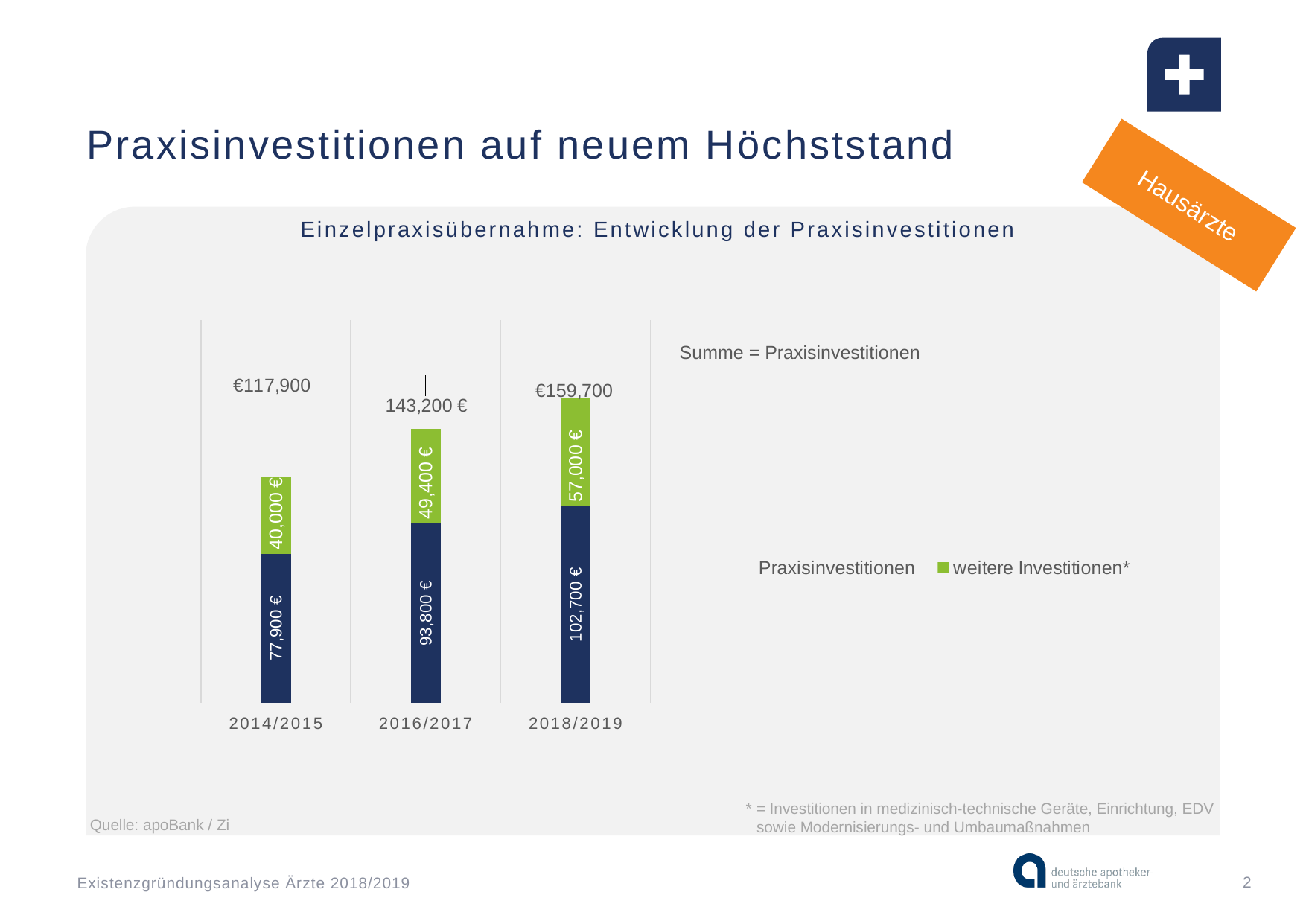
Which period has the lowest value for the weitere Investitionen* segment? 2014/2015 What is the title of the chart? Einzelpraxisübernahme: Entwicklung der Praxisinvestitionen What is the value of the dark blue Praxisinvestitionen segment for 2014/2015? 77,900 € How many periods are shown on the x axis? 3 Do the total Praxisinvestitionen rise or fall from 2014/2015 to 2018/2019? Rise What kind of chart is shown on the slide? Stacked bar chart What is the difference between the Praxisinvestitionen segment in 2018/2019 and in 2016/2017? 8,900 € Which is larger: the weitere Investitionen* segment in 2016/2017 or in 2014/2015? 2016/2017 What is the total shown above the 2016/2017 bar? 143,200 € What is the value of the green weitere Investitionen* segment for 2018/2019? 57,000 € Which period has the highest total Praxisinvestitionen? 2018/2019 How many series does the legend list? 2